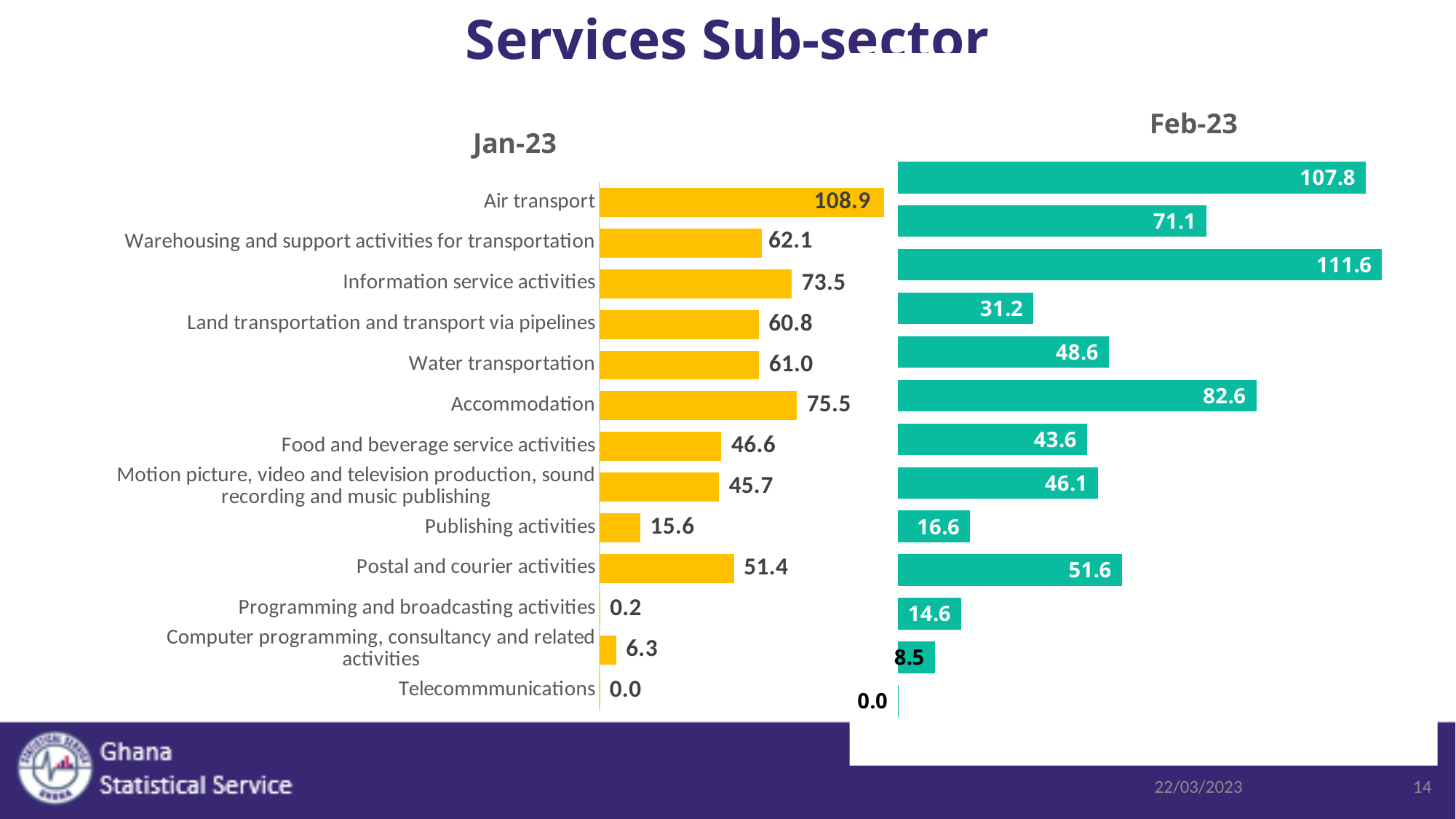
In the Feb-23 chart, what is the value for Information service activities? 111.6 How many categories are shown in the Jan-23 chart? 13 In the Feb-23 chart, what is the value for Land transportation and transport via pipelines? 31.2 In the Jan-23 chart, what is the value for Accommodation? 75.5 What is the difference between the Jan-23 value and the Feb-23 value for Air transport? 1.1 In the Feb-23 chart, what is the difference between Accommodation and Water transportation? 34.0 In the Jan-23 chart, which category has the highest value? Air transport In the Jan-23 chart, which category has the lowest value? Telecommmunications In the Feb-23 chart, which category has the highest value? Information service activities In the Jan-23 chart, what is the value for Publishing activities? 15.6 Which is larger for Warehousing and support activities for transportation: the Jan-23 value or the Feb-23 value? Feb-23 What type of chart is the Feb-23 chart? Bar chart